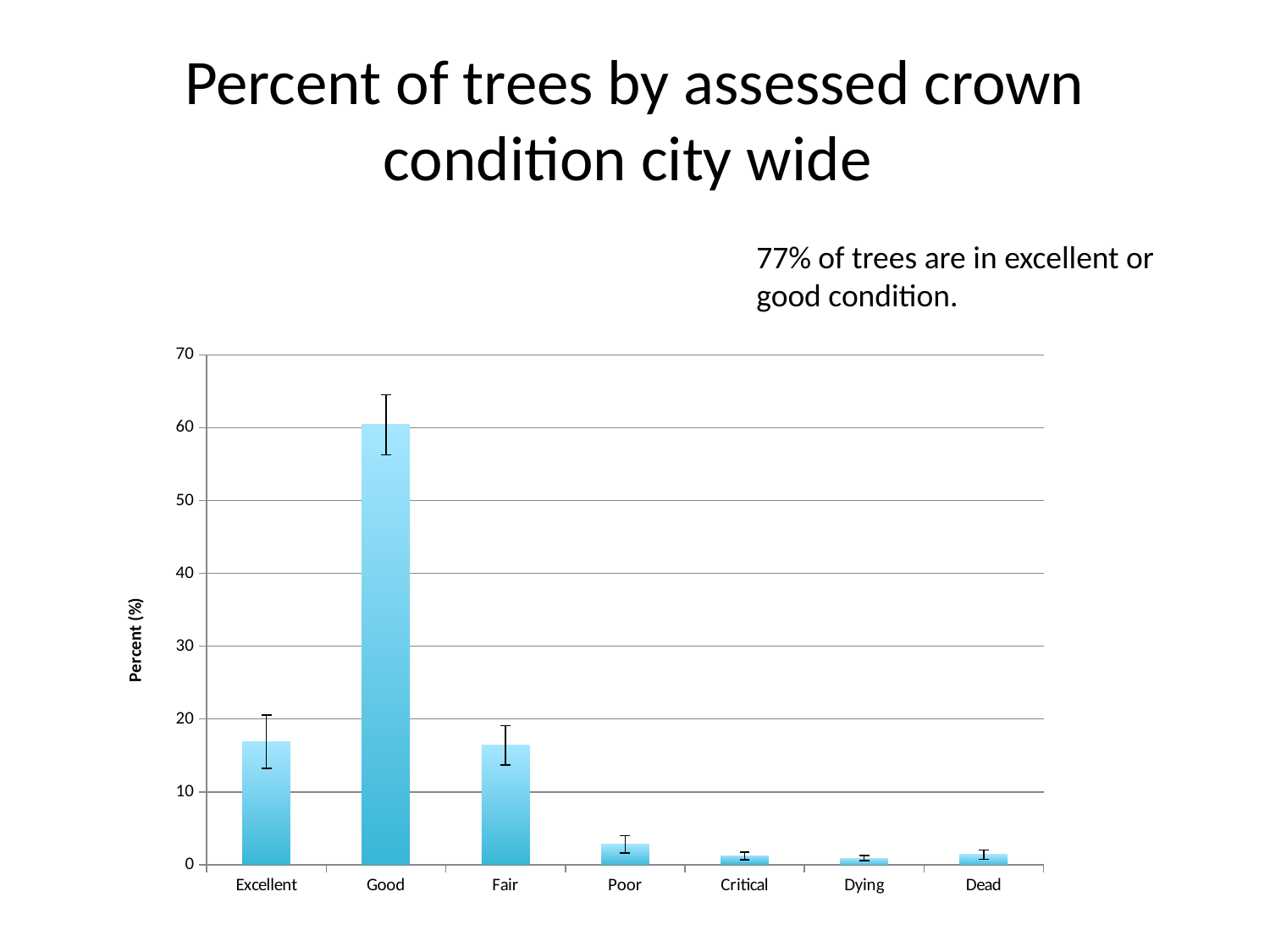
Which is larger, the value for Fair or the value for Poor? Fair What kind of chart is shown on the slide? bar chart Is the value for Good greater or less than 70? less How many crown condition categories are shown on the x axis? 7 Is the value for Poor greater or less than 10? less Is the value for Good greater or less than 50? greater Which is larger, the value for Good or the value for Excellent? Good Which crown condition category has the highest percentage of trees? Good What is the title of the chart on the slide? Percent of trees by assessed crown condition city wide What is the label on the y axis of the chart? Percent (%)